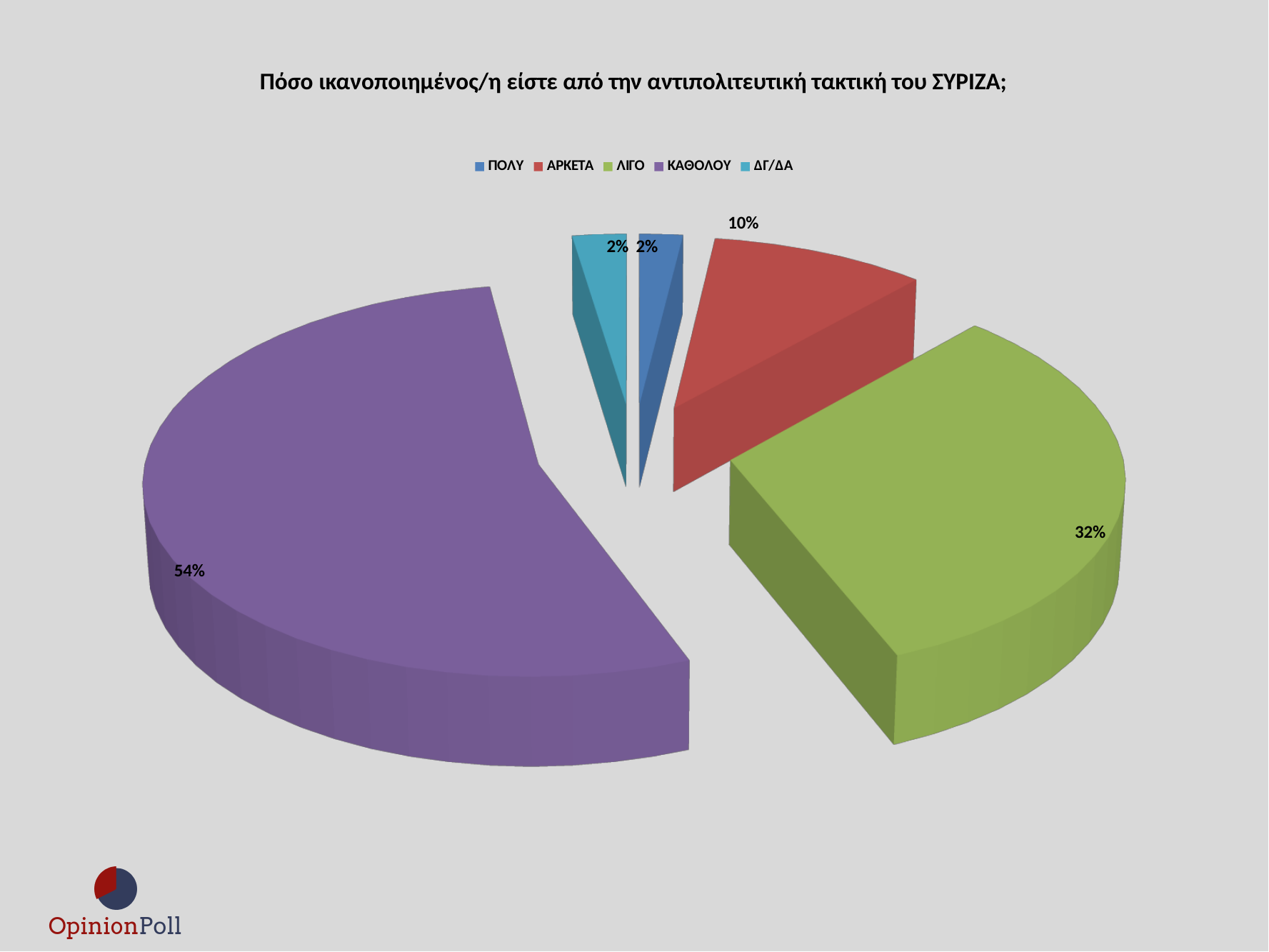
What is the combined percentage of ΠΟΛΥ and ΑΡΚΕΤΑ? 12% What type of chart is shown on the slide? Pie chart What percentage is shown for ΛΙΓΟ? 32% What percentage is shown for ΑΡΚΕΤΑ? 10% What is the difference in percentage points between ΚΑΘΟΛΟΥ and ΛΙΓΟ? 22 Which is larger, the share for ΑΡΚΕΤΑ or the share for ΛΙΓΟ? ΛΙΓΟ What percentage is shown for ΚΑΘΟΛΟΥ? 54% What is the title of the chart? Πόσο ικανοποιημένος/η είστε από την αντιπολιτευτική τακτική του ΣΥΡΙΖΑ; How many categories does the legend list? 5 Which category has the largest share of the pie? ΚΑΘΟΛΟΥ What percentage is shown for ΠΟΛΥ? 2% What colour is the slice for ΚΑΘΟΛΟΥ? Purple